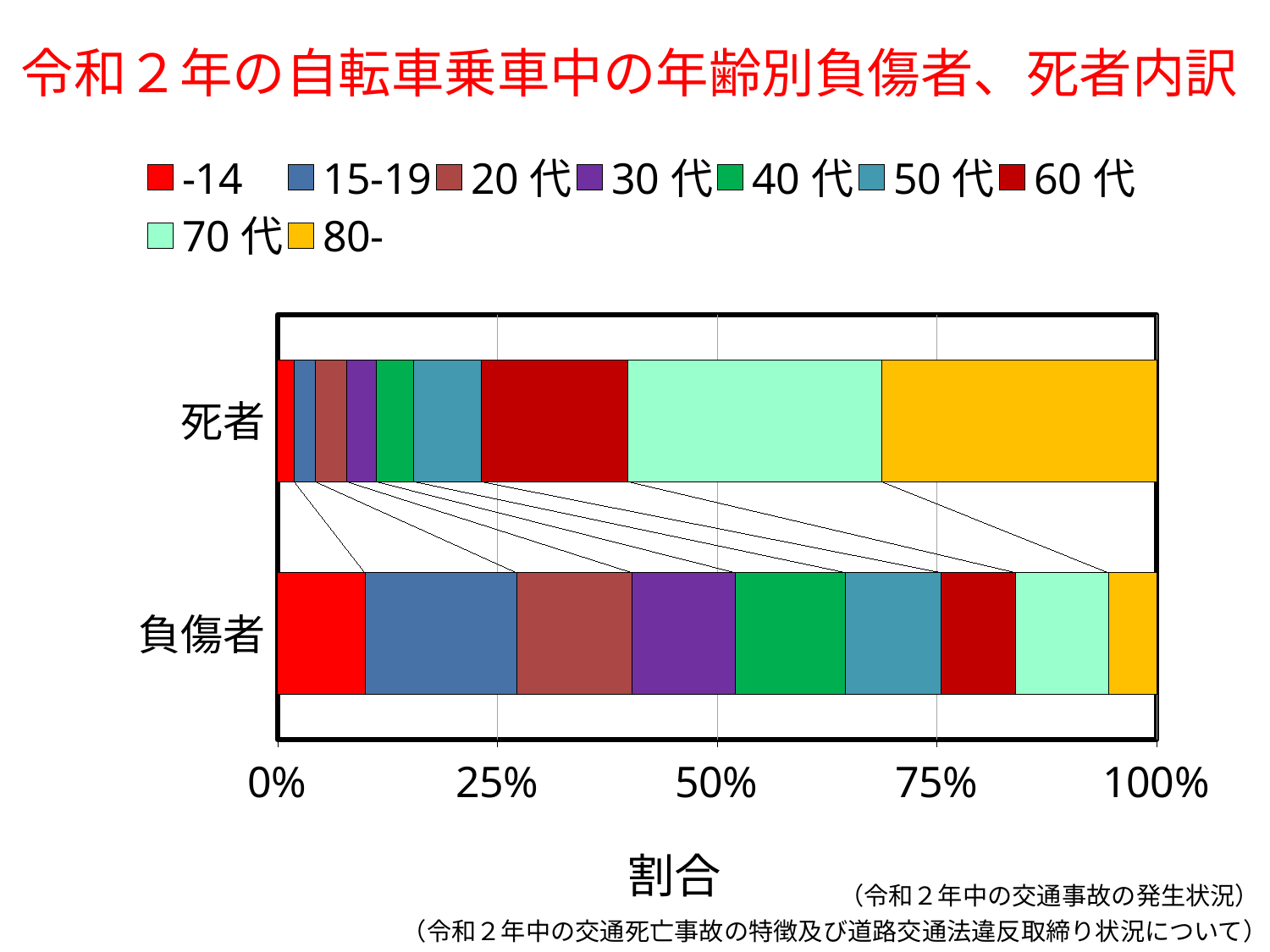
What kind of chart is shown on the slide? Stacked bar chart What is the label of the horizontal axis? 割合 In the 死者 bar, which age group has the smallest share? -14 In the 死者 bar, which age group has the largest share? 80- Is the share of -14 in the 負傷者 bar greater or less than 25%? less Is the share of 80- larger in the 死者 bar or in the 負傷者 bar? 死者 How many series does the legend list? 9 Is the share of 15-19 larger in the 死者 bar or in the 負傷者 bar? 負傷者 In the 負傷者 bar, which age group has the largest share? 15-19 How many categories (bars) does the chart show? 2 Is the share of 70 代 in the 死者 bar greater or less than 25%? greater In the 負傷者 bar, which age group has the smallest share? 80-